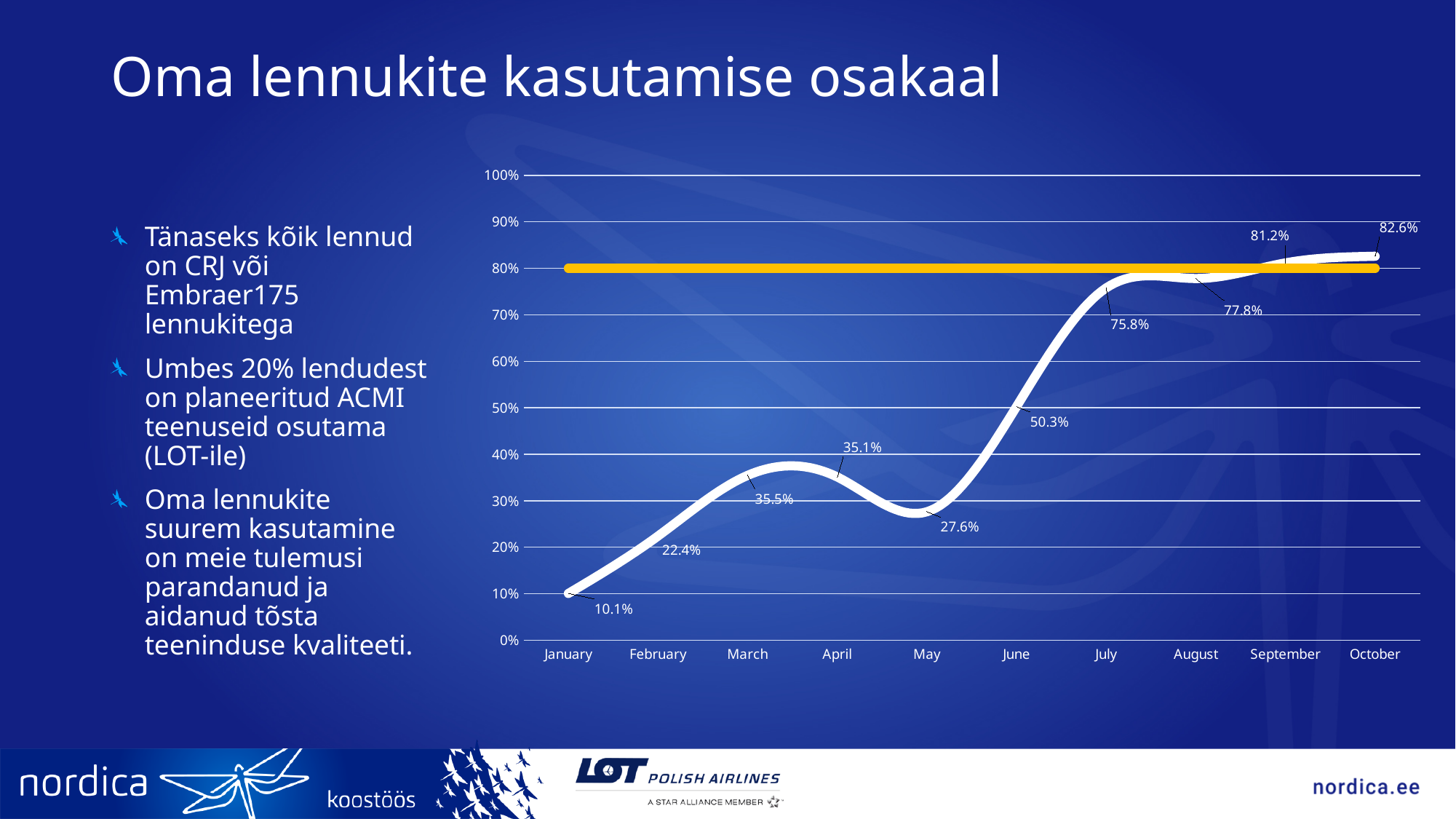
How many months are shown on the x axis? 10 What is the difference between the values for July and June? 25.5% Which month has the lowest value? January Is the value for August greater or less than 80%? less What is the value for January? 10.1% At what level is the horizontal yellow line drawn? 80% Do the values rise or fall from May to October? rise Which is larger, the value for March or the value for April? March Which month has the highest value? October What is the value for June? 50.3% What kind of chart is shown on the slide? line chart What is the value for October? 82.6%